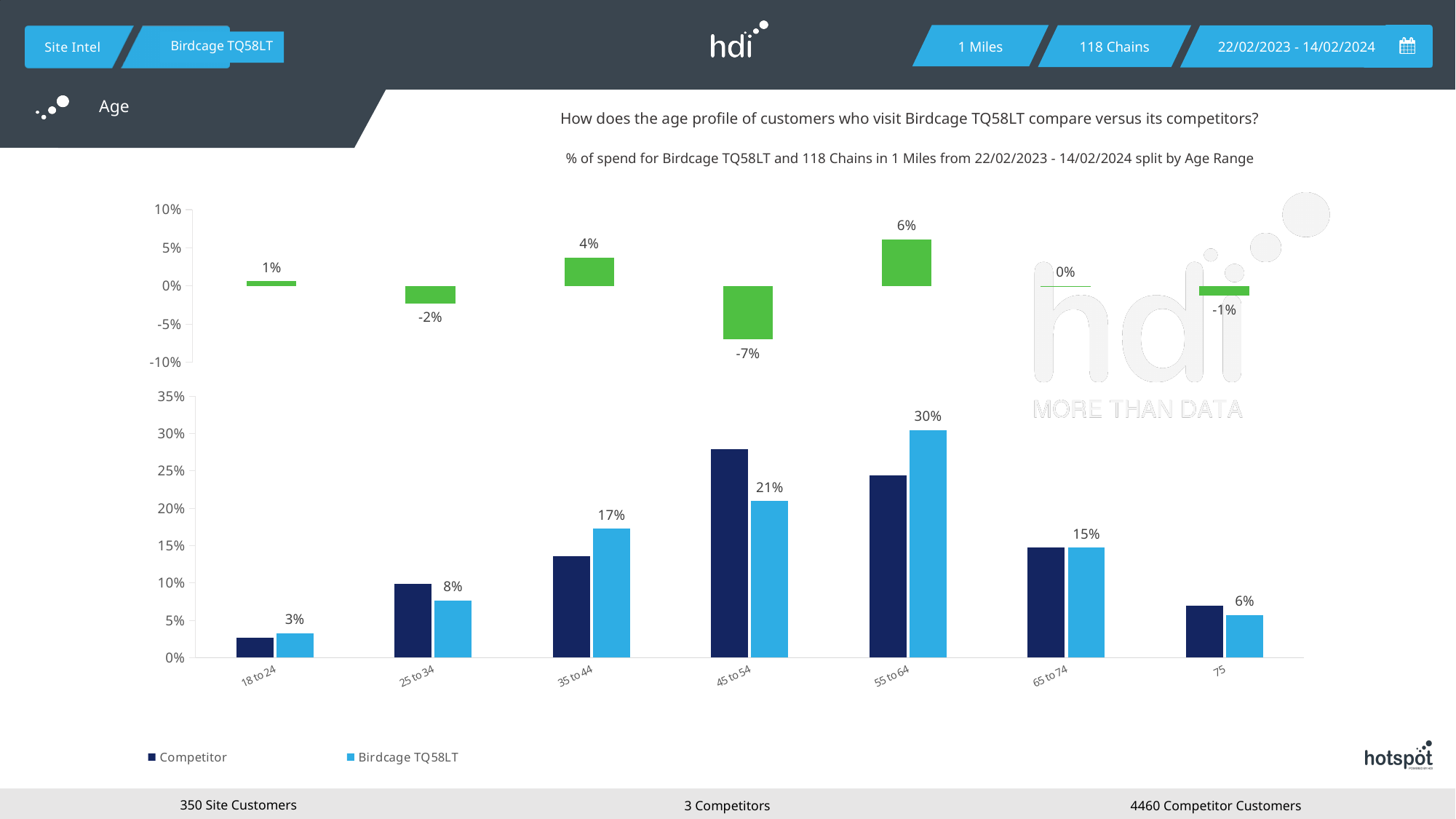
In the bottom bar chart, how many series does the legend list? 2 In the bottom bar chart, which age range has the highest Birdcage TQ58LT value? 55 to 64 What kind of chart is the bottom chart? bar chart In the top chart, which age range has the highest value? 55 to 64 In the bottom bar chart, how many age range categories are shown? 7 In the top chart, what is the value for the 45 to 54 age range? -7% In the bottom bar chart, is the Competitor value for 45 to 54 greater or less than 25%? greater In the bottom bar chart, what is the value for Birdcage TQ58LT in the 55 to 64 age range? 30% In the bottom bar chart, what is the difference between the Birdcage TQ58LT values for 55 to 64 and 45 to 54? 9% In the bottom bar chart, for the 45 to 54 age range, which series has the larger value, Competitor or Birdcage TQ58LT? Competitor In the bottom bar chart, which age range has the lowest Birdcage TQ58LT value? 18 to 24 In the bottom bar chart, what is the value for Birdcage TQ58LT in the 18 to 24 age range? 3%